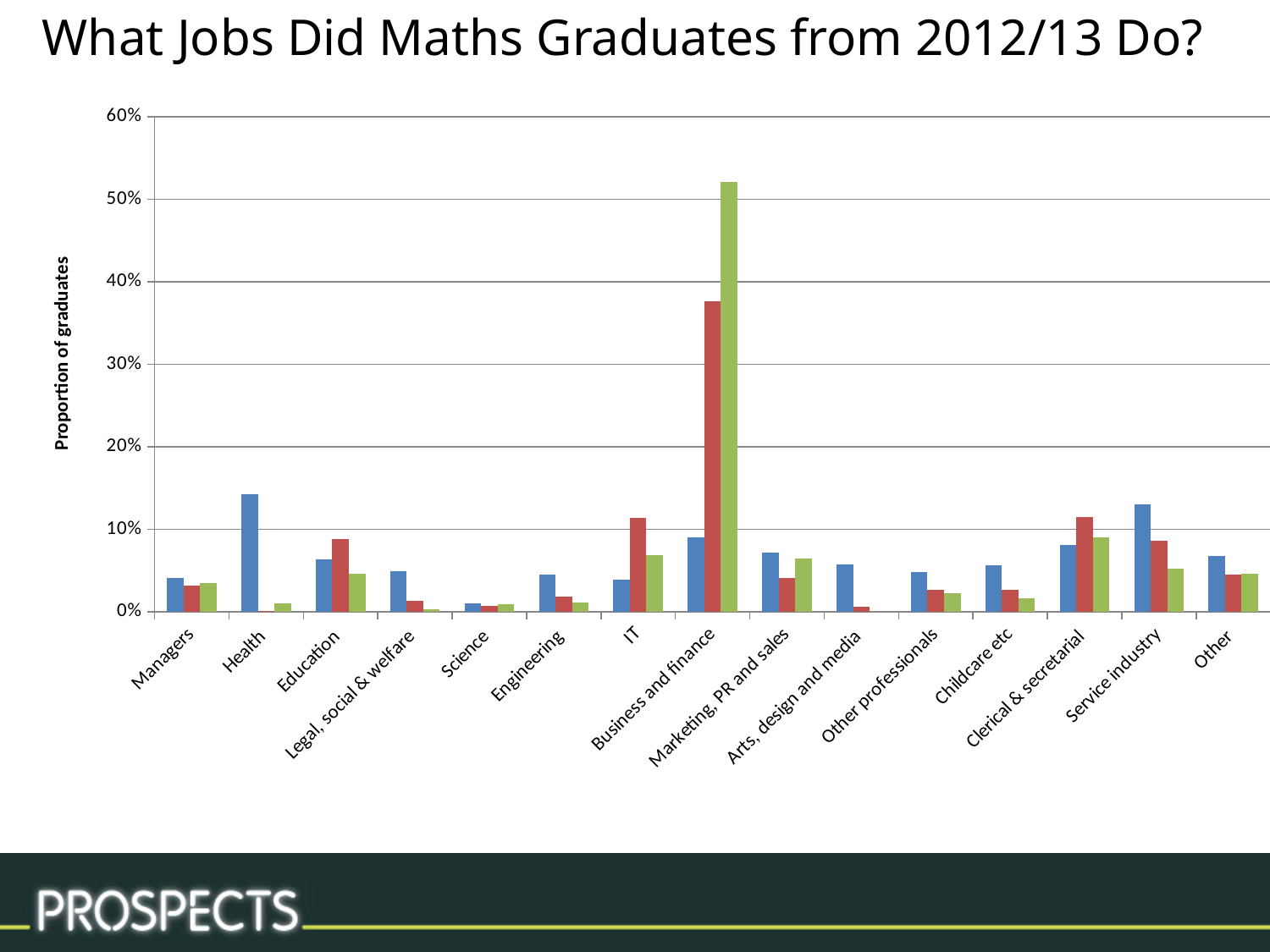
What kind of chart is shown on the slide? bar chart Is the red bar for Business and finance greater or less than 40%? less How many job categories are shown along the x axis? 15 What is the title of the chart on the slide? What Jobs Did Maths Graduates from 2012/13 Do? Is the blue bar for Health greater or less than 10%? greater Which job category has the tallest bar in the chart? Business and finance Is the green bar for Business and finance greater or less than 50%? greater What is the label on the vertical axis of the chart? Proportion of graduates Which is larger for Business and finance, the green bar or the red bar? the green bar